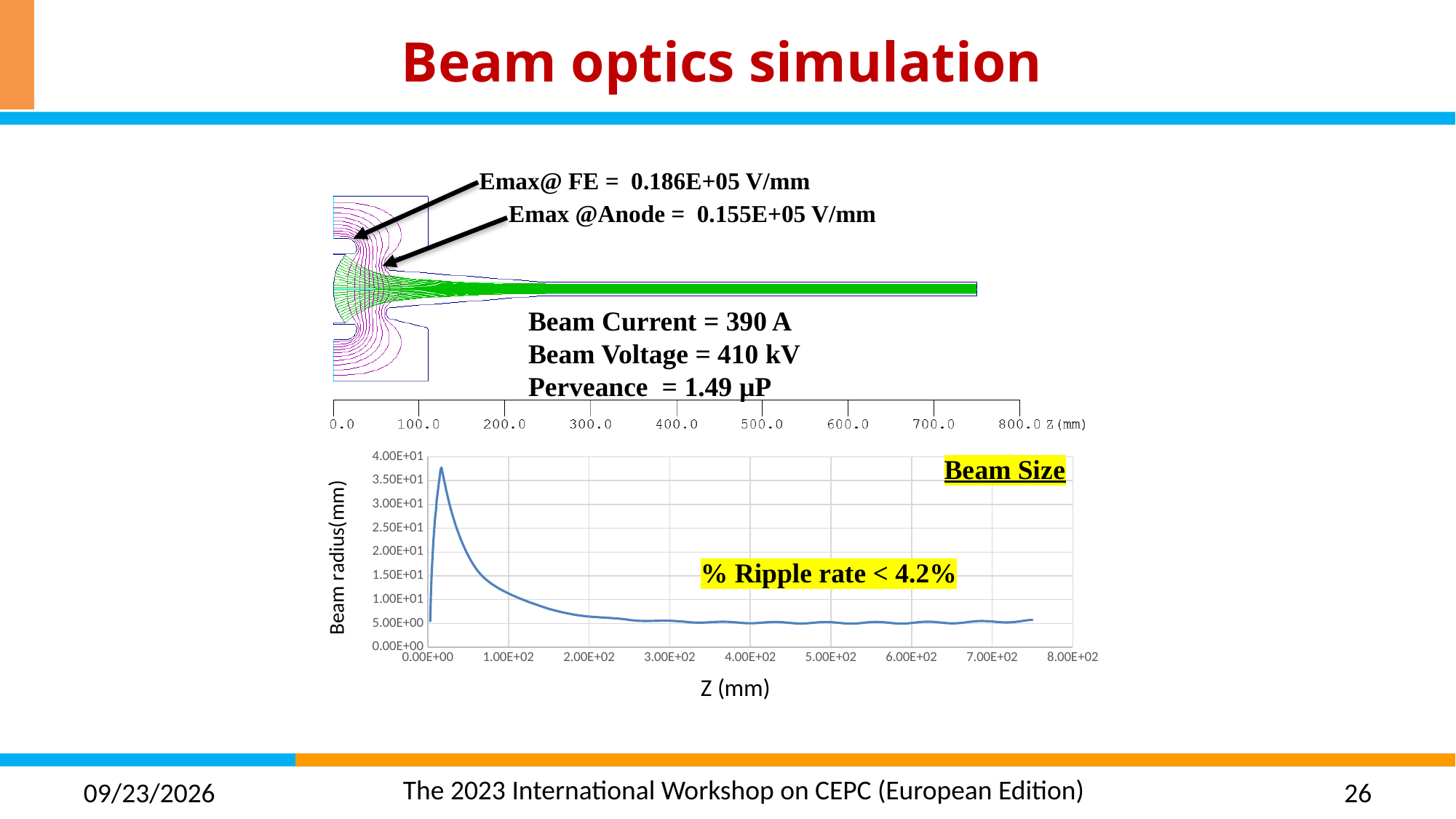
In the Beam Size chart, is the peak beam radius greater or less than 3.00E+01? greater In the Beam Size chart, is the beam radius larger at Z = 1.00E+02 or at Z = 5.00E+02? Z = 1.00E+02 What kind of chart is the Beam Size chart? line chart How many lines are plotted in the Beam Size chart? 1 In the Beam Size chart, is the beam radius at Z = 4.00E+02 greater or less than 1.00E+01? less In the Beam Size chart, is the beam radius at Z = 1.00E+02 greater or less than 1.00E+01? greater What is the label of the vertical axis of the Beam Size chart? Beam radius(mm) In the Beam Size chart, does the beam radius rise or fall between Z = 1.00E+02 and Z = 3.00E+02? fall What is the maximum value shown on the vertical axis of the Beam Size chart? 4.00E+01 What is the title shown on the lower chart? Beam Size